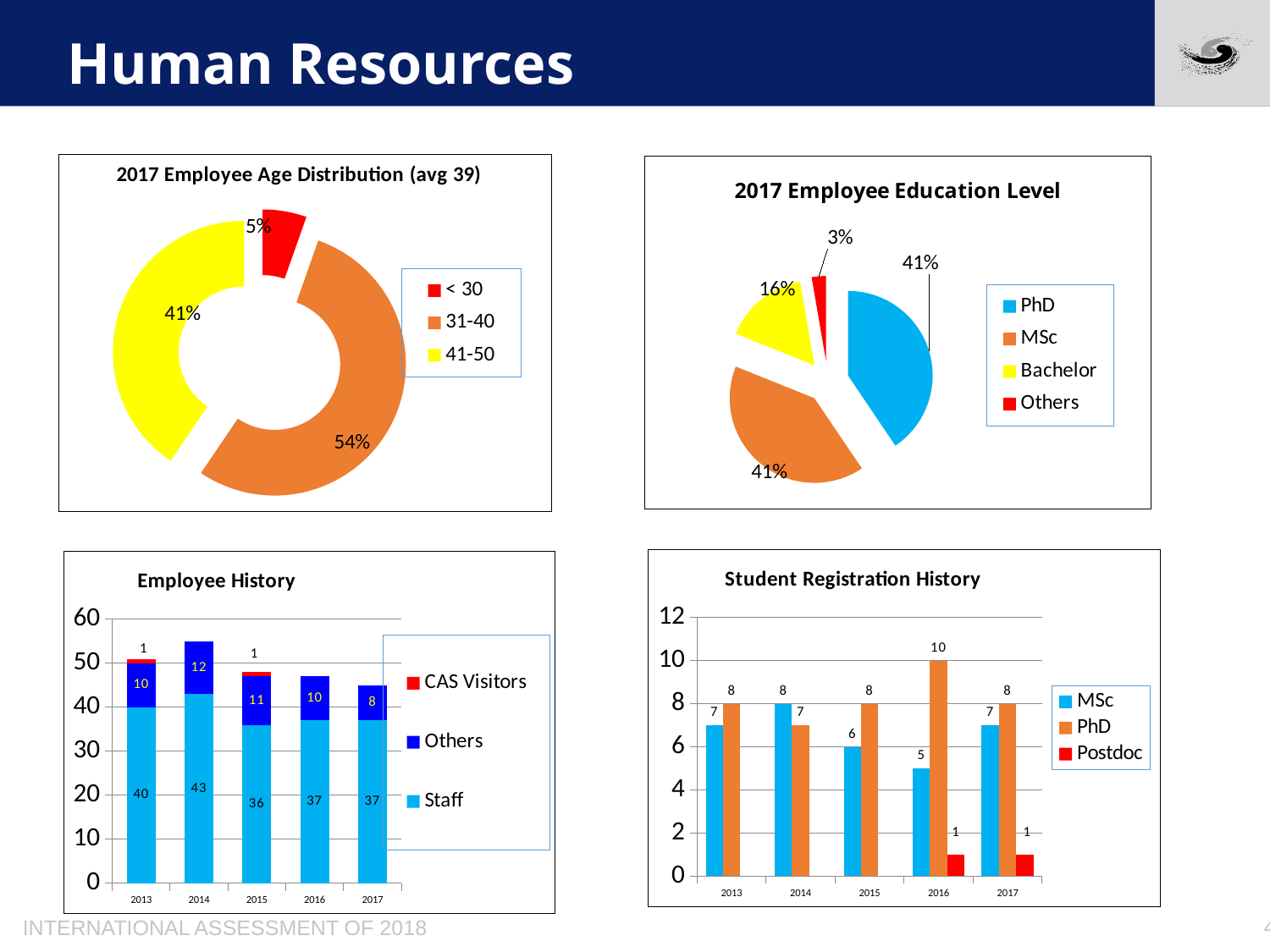
In the 2017 Employee Age Distribution chart, which age group has the smallest share? < 30 In the 2017 Employee Age Distribution chart, what share of employees are aged 31-40? 54% What kind of chart is the Employee History chart? Stacked bar chart In the Employee History chart, what is the total of the stacked bar for 2013? 51 In the Student Registration History chart, which year has the highest PhD value? 2016 In the Employee History chart, what is the Staff value for 2014? 43 In the 2017 Employee Education Level chart, what share of employees hold a Bachelor degree? 16% In the Student Registration History chart, what is the difference between the PhD and MSc values in 2016? 5 In the Student Registration History chart, what is the PhD value for 2016? 10 In the Employee History chart, how many years are shown on the x axis? 5 In the Student Registration History chart, which is larger in 2014, MSc or PhD? MSc In the 2017 Employee Education Level chart, how many categories does the legend list? 4